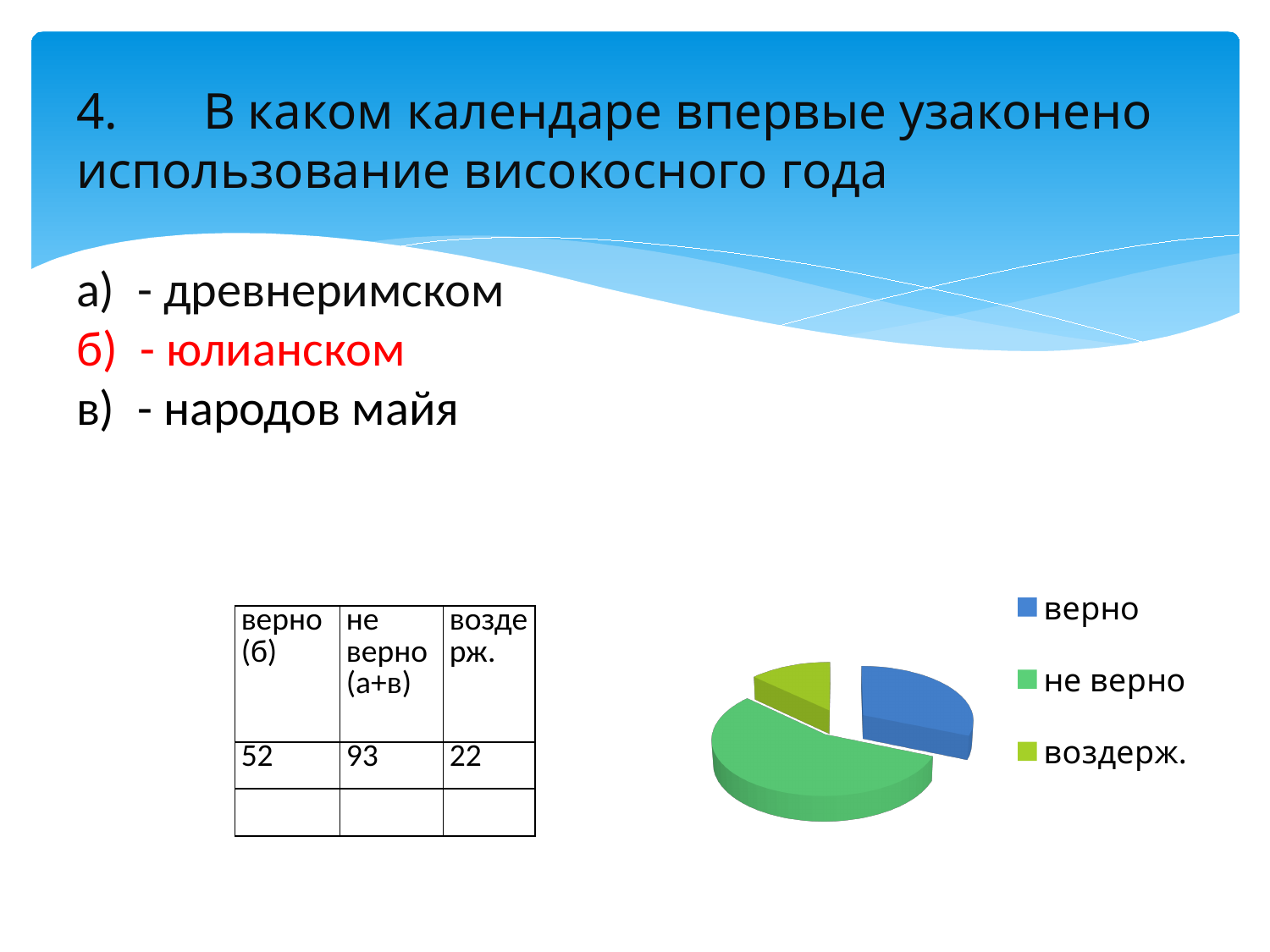
How many entries does the pie chart's legend list? 3 According to the table next to the pie chart, what is the value for воздерж.? 22 Which category has the largest slice in the pie chart? не верно Which slice is larger in the pie chart, верно or воздерж.? верно Which category has the smallest slice in the pie chart? воздерж. According to the table next to the pie chart, what is the value for не верно? 93 Which slice is larger in the pie chart, верно or не верно? не верно What kind of chart is shown on the slide? pie chart How many slices does the pie chart have? 3 What colour is the не верно slice in the pie chart? green According to the table next to the pie chart, what is the value for верно? 52 Using the values in the table, what is the difference between не верно and верно? 41